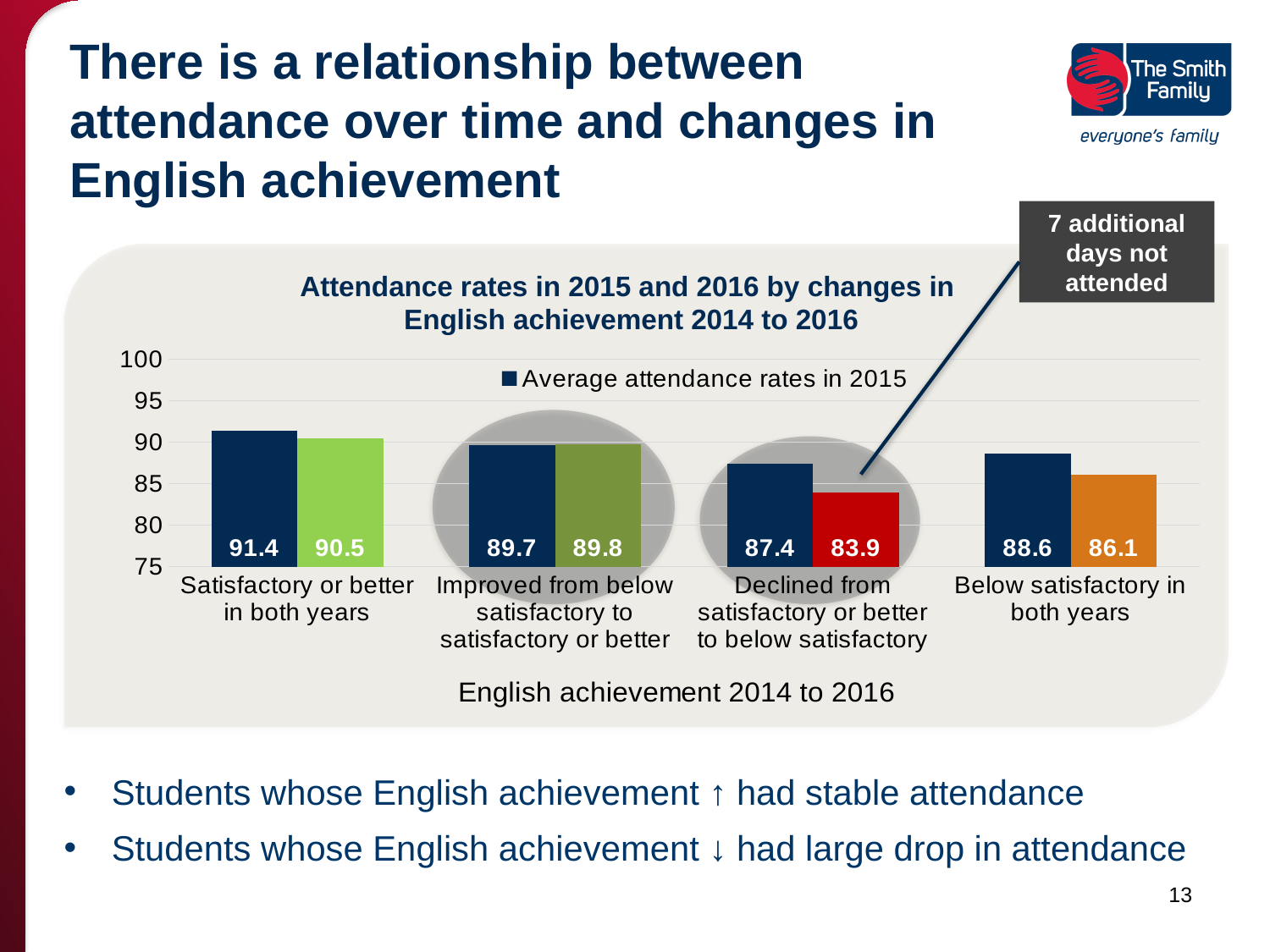
What is the value of the second (orange) bar for 'Below satisfactory in both years'? 86.1 For the 'Declined from satisfactory or better to below satisfactory' category, what is the difference between the two bars (87.4 and 83.9)? 3.5 For 'Satisfactory or better in both years', what is the difference between the 2015 value and the second bar's value? 0.9 Is the 2015 attendance rate for 'Below satisfactory in both years' greater or less than 85? greater What is the average attendance rate in 2015 for students with 'Satisfactory or better in both years'? 91.4 Which category has the highest average attendance rate in 2015 (dark blue bar)? Satisfactory or better in both years How many categories of English achievement change are shown on the x axis? 4 For 'Improved from below satisfactory to satisfactory or better', which bar has the larger value, the dark blue bar (89.7) or the green bar (89.8)? The green bar (89.8) What type of chart is shown on the slide? Bar chart What is the value of the red bar for the 'Declined from satisfactory or better to below satisfactory' category? 83.9 What does the callout box pointing to the 'Declined' category say? 7 additional days not attended What is the lowest value shown on the chart? 83.9